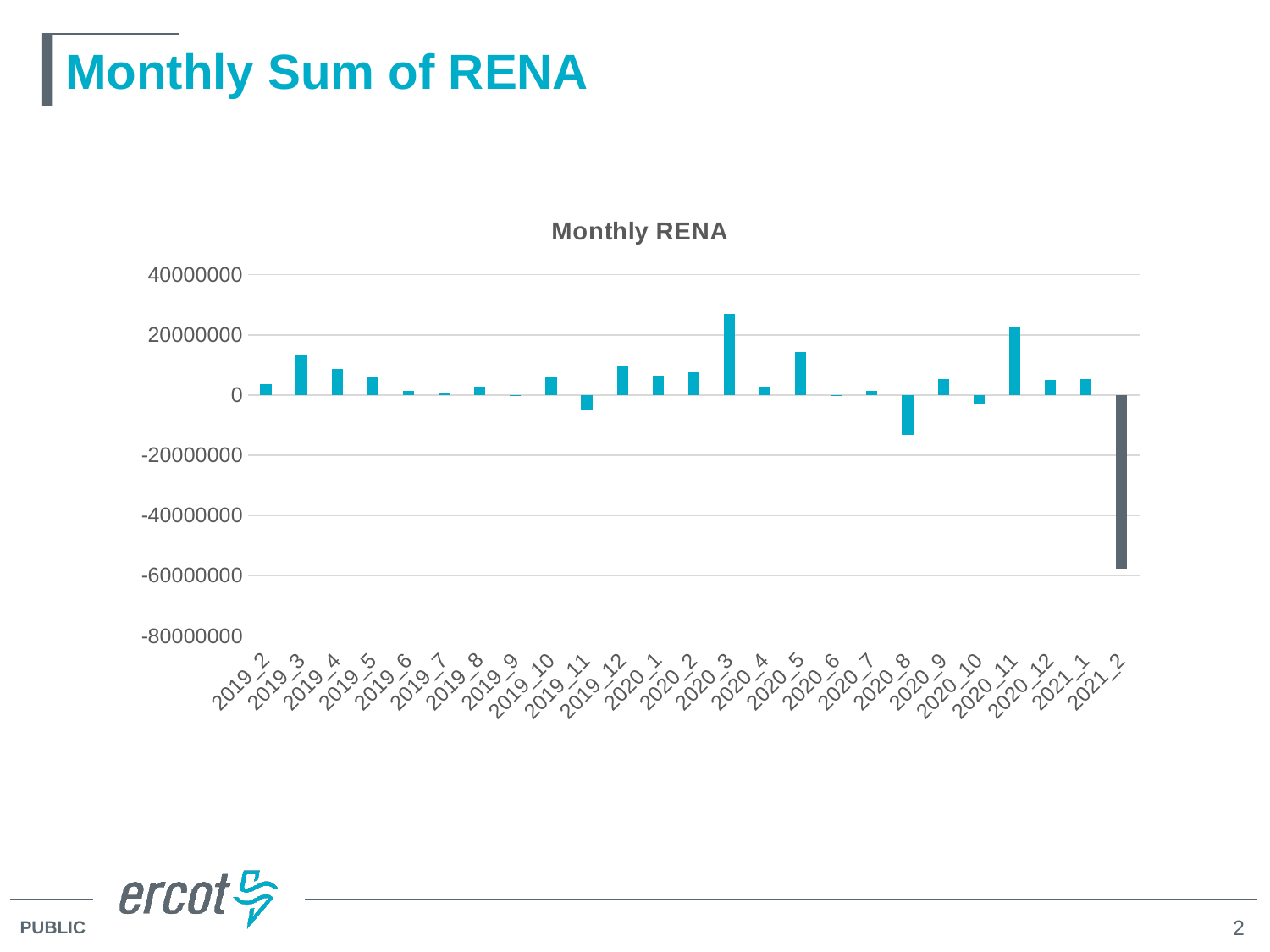
Which month has the lowest value? 2021_2 Is the value for 2020_3 greater or less than 20000000? greater What is the title of the chart? Monthly RENA Is the value for 2020_8 greater or less than 0? less Is the value for 2021_2 greater or less than -40000000? less Which month's bar is drawn in a different colour (dark grey) from the other teal bars? 2021_2 Which month has the highest value? 2020_3 How many months (categories) are plotted on the x axis? 25 What kind of chart is shown on the slide? bar chart Which is larger, the value for 2019_3 or the value for 2019_4? 2019_3 Which is larger, the value for 2020_4 or the value for 2020_5? 2020_5